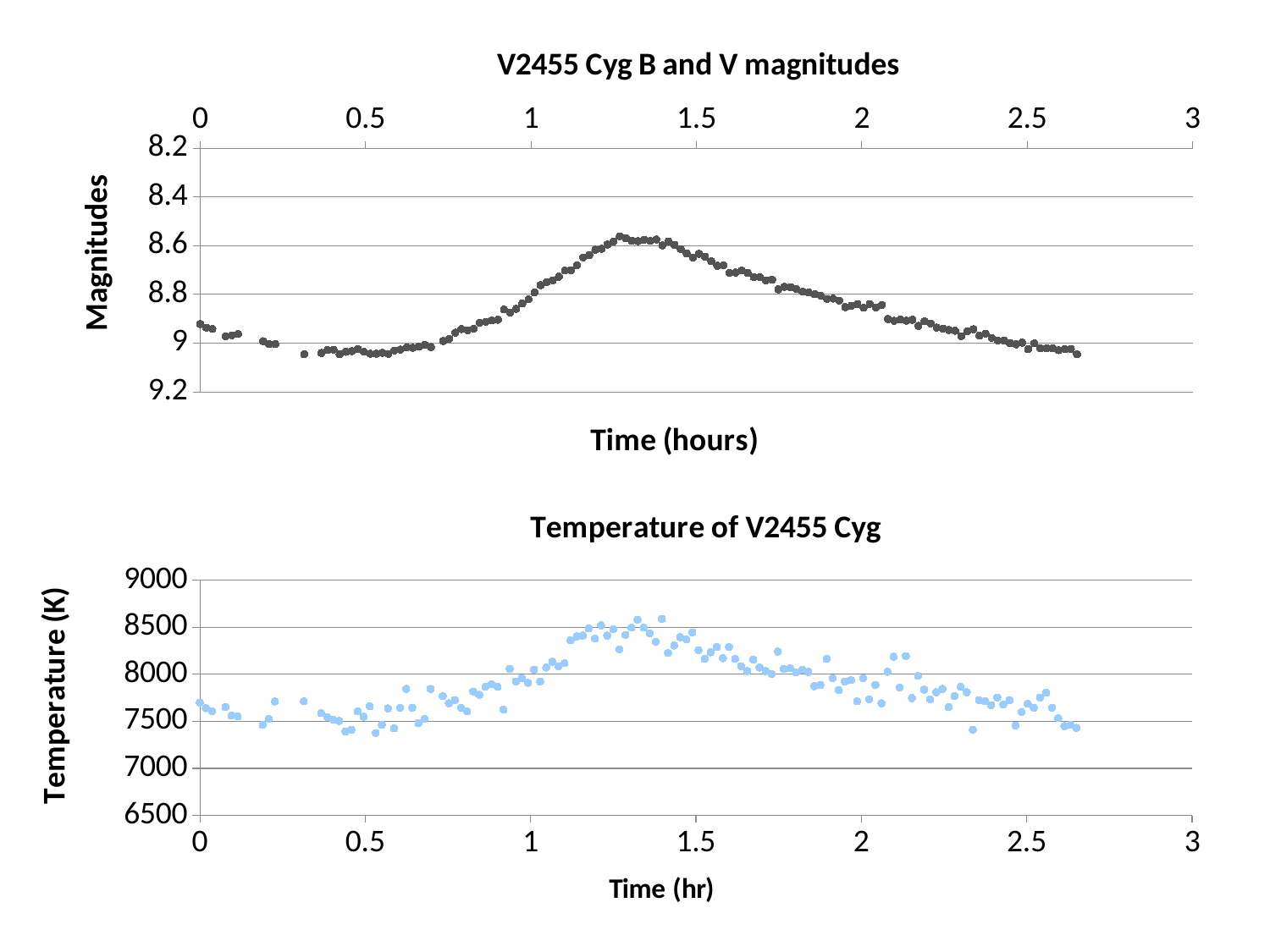
What kind of chart is the bottom chart, 'Temperature of V2455 Cyg'? scatter chart In the bottom chart, 'Temperature of V2455 Cyg', is the temperature higher at 0.5 hours or at 1.3 hours? 1.3 hours What is the y-axis label of the top chart, 'V2455 Cyg B and V magnitudes'? Magnitudes In the top chart, 'V2455 Cyg B and V magnitudes', is the magnitude value at 1.3 hours greater or less than 8.8? less In the top chart, 'V2455 Cyg B and V magnitudes', do the magnitude values rise or fall between 1.3 and 2.6 hours? rise In the bottom chart, 'Temperature of V2455 Cyg', is the temperature at 1.3 hours greater or less than 8000? greater In the bottom chart, 'Temperature of V2455 Cyg', is the temperature at 0.5 hours greater or less than 8000? less How many charts are shown on the slide? 2 In the bottom chart, 'Temperature of V2455 Cyg', does the temperature rise or fall between 1.3 and 2.6 hours? fall What is the title of the bottom chart? Temperature of V2455 Cyg What kind of chart is the top chart, 'V2455 Cyg B and V magnitudes'? scatter chart